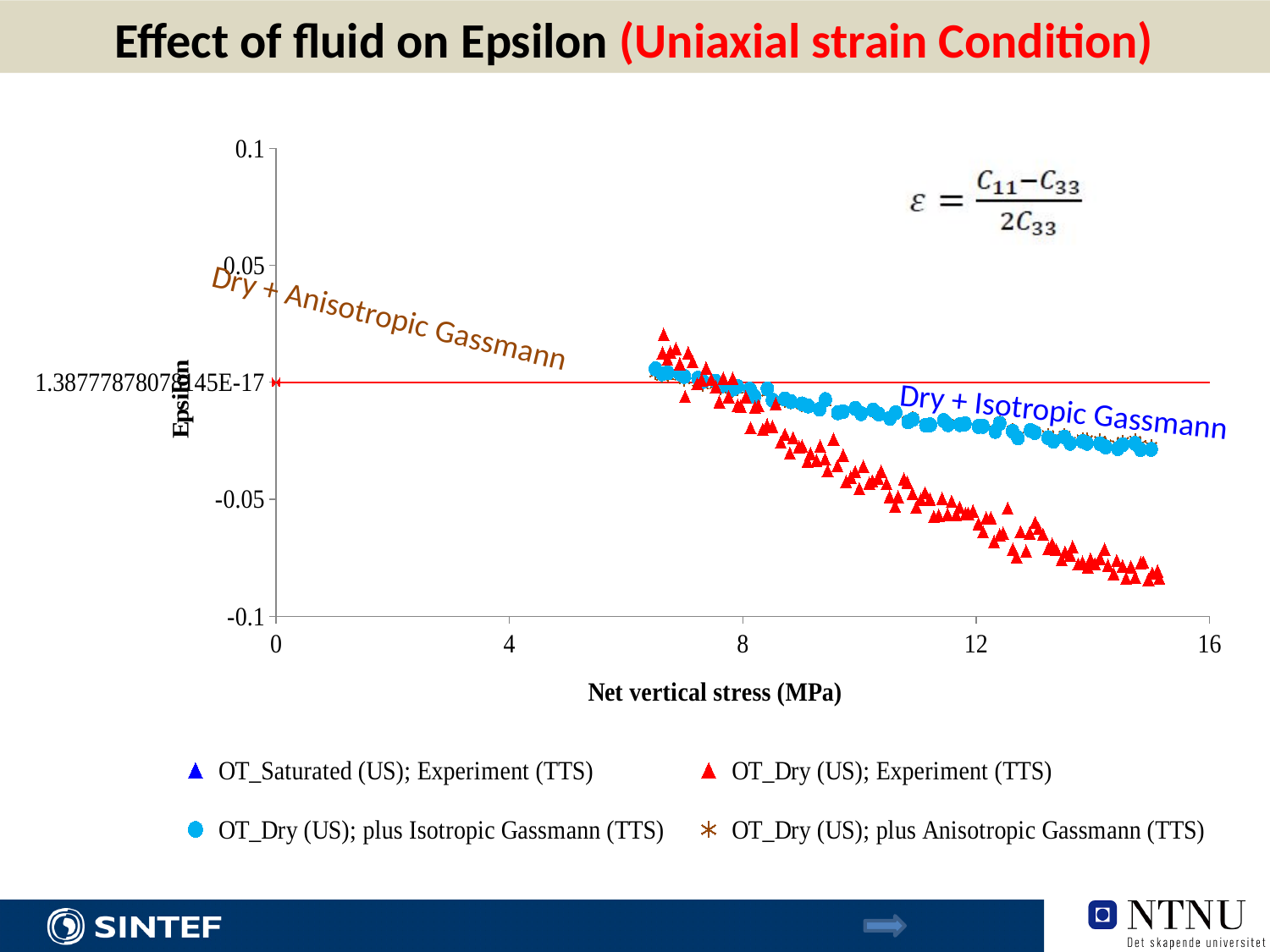
Do the values of the OT_Dry (US); Experiment (TTS) series rise or fall as net vertical stress increases? fall At a net vertical stress of about 14 MPa, which series has the higher Epsilon value: OT_Dry (US); Experiment (TTS) or OT_Dry (US); plus Isotropic Gassmann (TTS)? OT_Dry (US); plus Isotropic Gassmann (TTS) What is the title of the y axis? Epsilon At a net vertical stress of about 15 MPa, is the value of the OT_Dry (US); plus Isotropic Gassmann (TTS) series greater or less than -0.05? greater At a net vertical stress of about 15 MPa, is the value of the OT_Dry (US); Experiment (TTS) series greater or less than -0.05? less What is the maximum value shown on the x axis? 16 What is the title of the x axis? Net vertical stress (MPa) What kind of chart is shown on the slide? scatter chart At a net vertical stress of about 7 MPa, is the value of the OT_Dry (US); Experiment (TTS) series greater or less than 0.05? less Do the values of the OT_Dry (US); plus Isotropic Gassmann (TTS) series rise or fall as net vertical stress increases? fall How many series does the legend list? 4